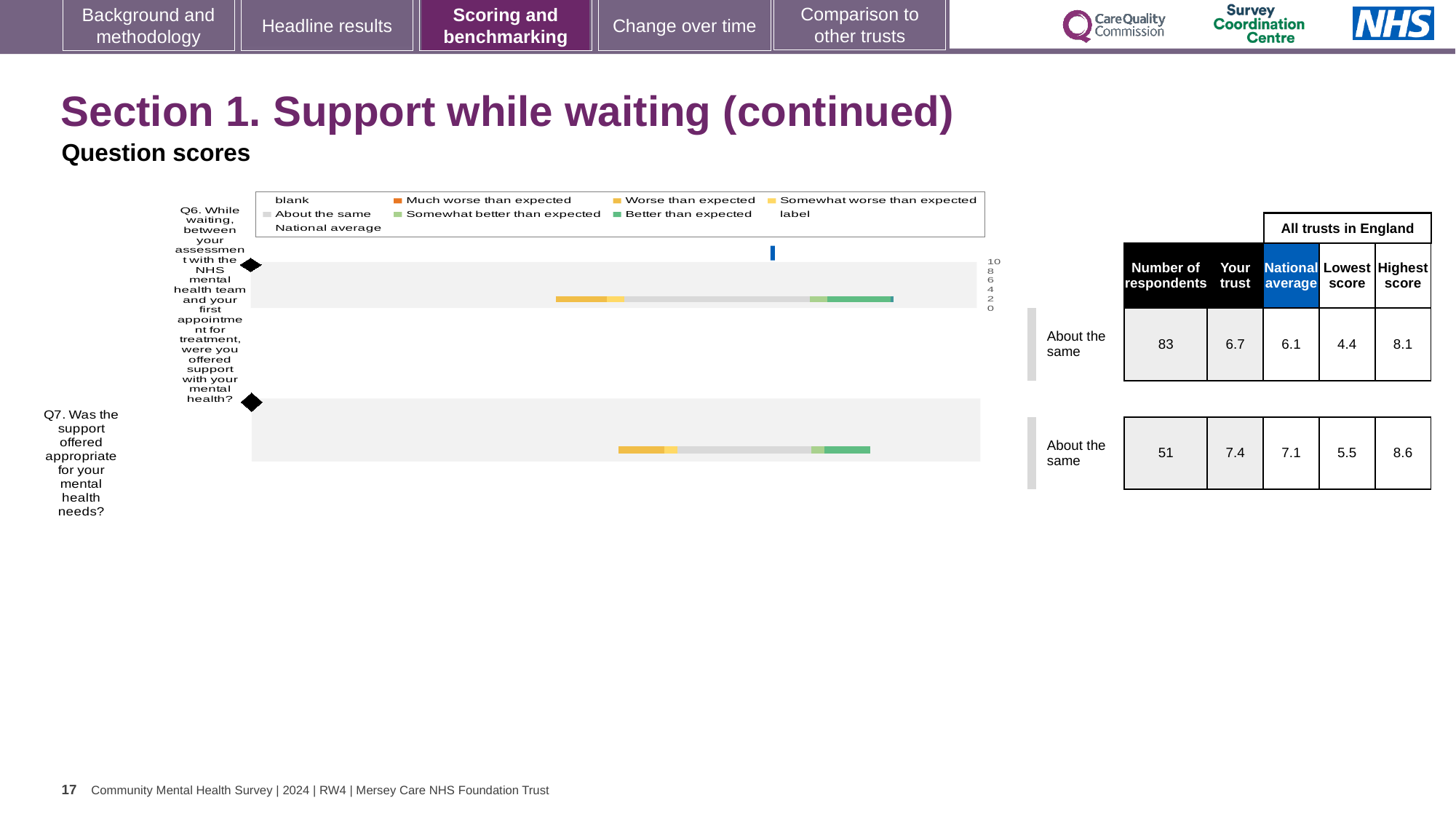
What colour represents 'Better than expected' in the chart legend? green How many entries does the chart legend list? 9 What is the highest score among all trusts in England for Q7? 8.6 What is the difference between the highest score and the lowest score for Q7? 3.1 For Q6, which is larger: the 'Your trust' score or the national average? Your trust How many questions are plotted in the chart? 2 How many respondents answered Q6 according to the table next to the chart? 83 What colour represents 'Much worse than expected' in the chart legend? orange What benchmark category is shown for Q7? About the same What is the national average score for Q7? 7.1 What kind of chart is used to show the question scores for Q6 and Q7? bar chart What is the 'Your trust' score for Q6? 6.7